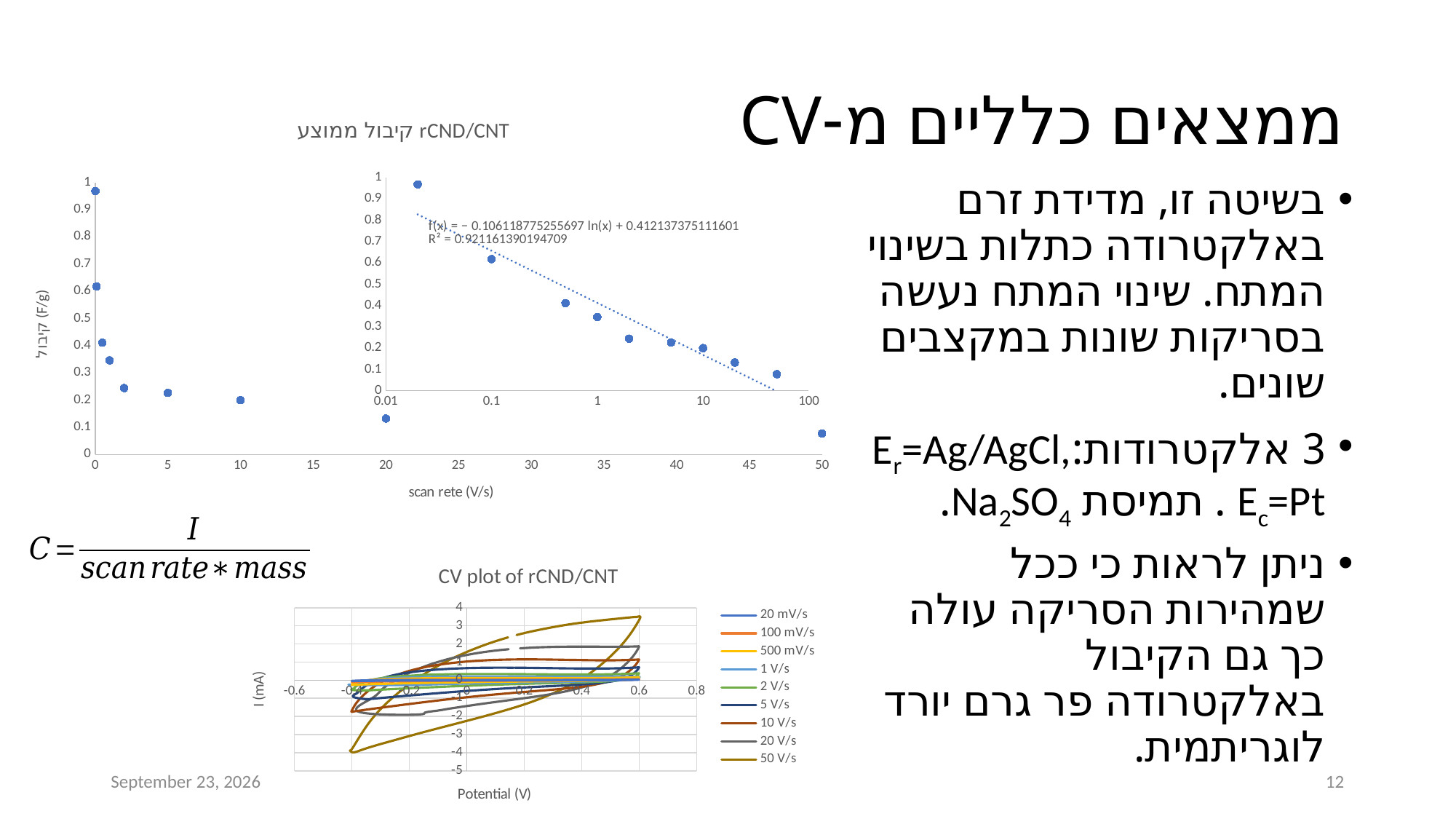
What kind of chart is the bottom chart 'CV plot of rCND/CNT'? line chart In the top-left chart 'rCND/CNT קיבול ממוצע', is the value at a scan rate of 50 V/s greater or less than 0.1? less In the top-left chart 'rCND/CNT קיבול ממוצע', which is larger: the value at a scan rate of 20 V/s or the value at 50 V/s? 20 V/s In the bottom chart 'CV plot of rCND/CNT', which series reaches the highest current? 50 V/s In the top-left chart 'rCND/CNT קיבול ממוצע', do the values rise or fall as the scan rate increases? fall In the top-left chart 'rCND/CNT קיבול ממוצע', is the highest plotted value greater or less than 0.9? greater What kind of chart is the top-left chart 'rCND/CNT קיבול ממוצע'? scatter chart In the top-left chart 'rCND/CNT קיבול ממוצע', how many data points are plotted? 9 In the top-left chart 'rCND/CNT קיבול ממוצע', is the value at a scan rate of 10 V/s greater or less than 0.3? less In the bottom chart 'CV plot of rCND/CNT', how many series does the legend list? 9 In the bottom chart 'CV plot of rCND/CNT', what is the label of the x axis? Potential (V) What is the title of the bottom chart? CV plot of rCND/CNT